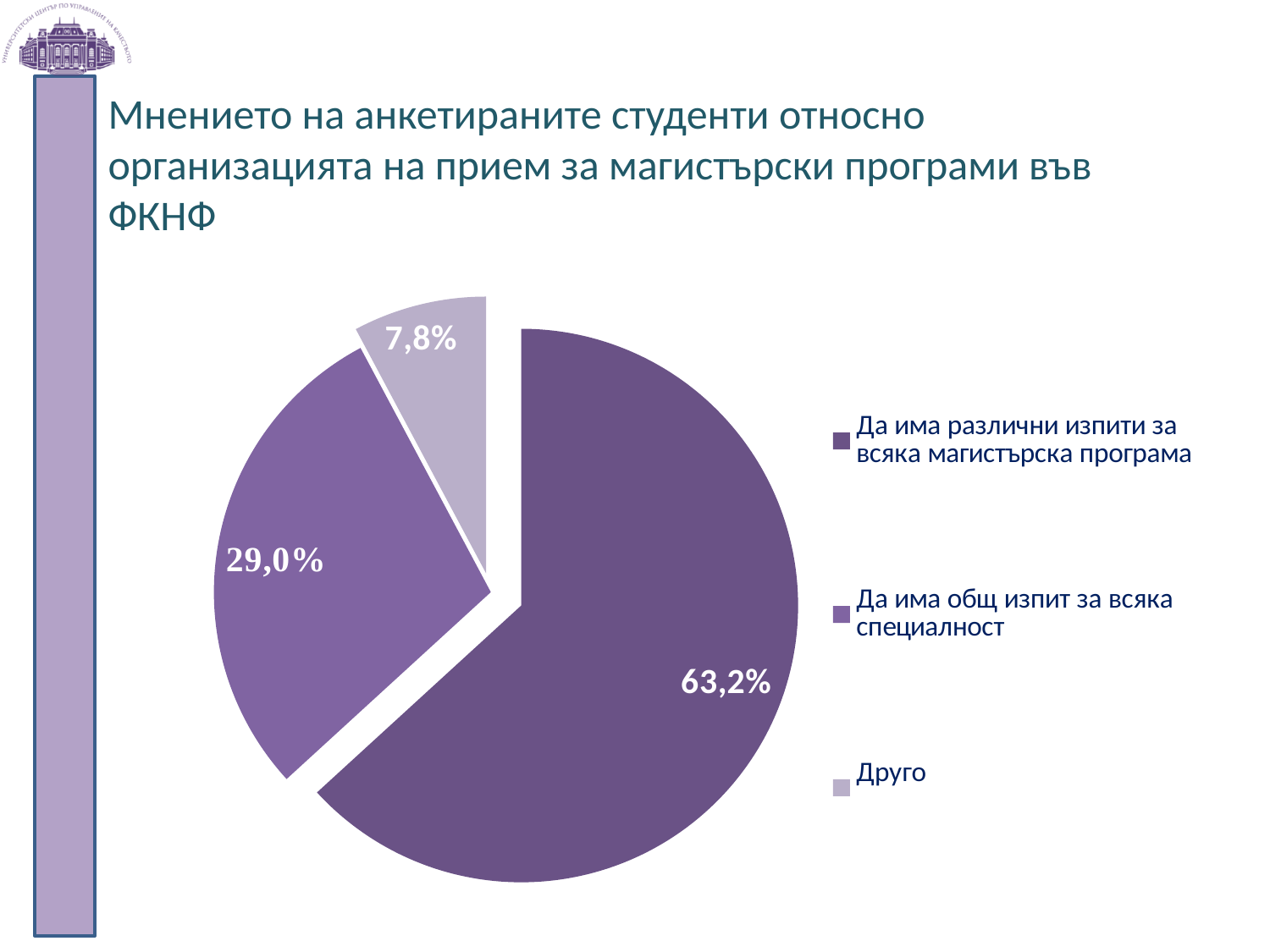
Which slice is shown in the lightest shade of purple? Друго How many slices does the pie chart have? 3 Which category has the largest share of the pie? Да има различни изпити за всяка магистърска програма What share of respondents chose "Да има общ изпит за всяка специалност"? 29,0% What share of respondents chose "Друго"? 7,8% What kind of chart is shown on the slide? pie chart What is the title of the chart on the slide? Мнението на анкетираните студенти относно организацията на прием за магистърски програми във ФКНФ What is the difference in percentage points between "Да има различни изпити за всяка магистърска програма" and "Да има общ изпит за всяка специалност"? 34,2 percentage points How many entries does the legend list? 3 Which category has the smallest share of the pie? Друго Which is larger: the share for "Да има общ изпит за всяка специалност" or the share for "Друго"? Да има общ изпит за всяка специалност What share of respondents chose "Да има различни изпити за всяка магистърска програма"? 63,2%